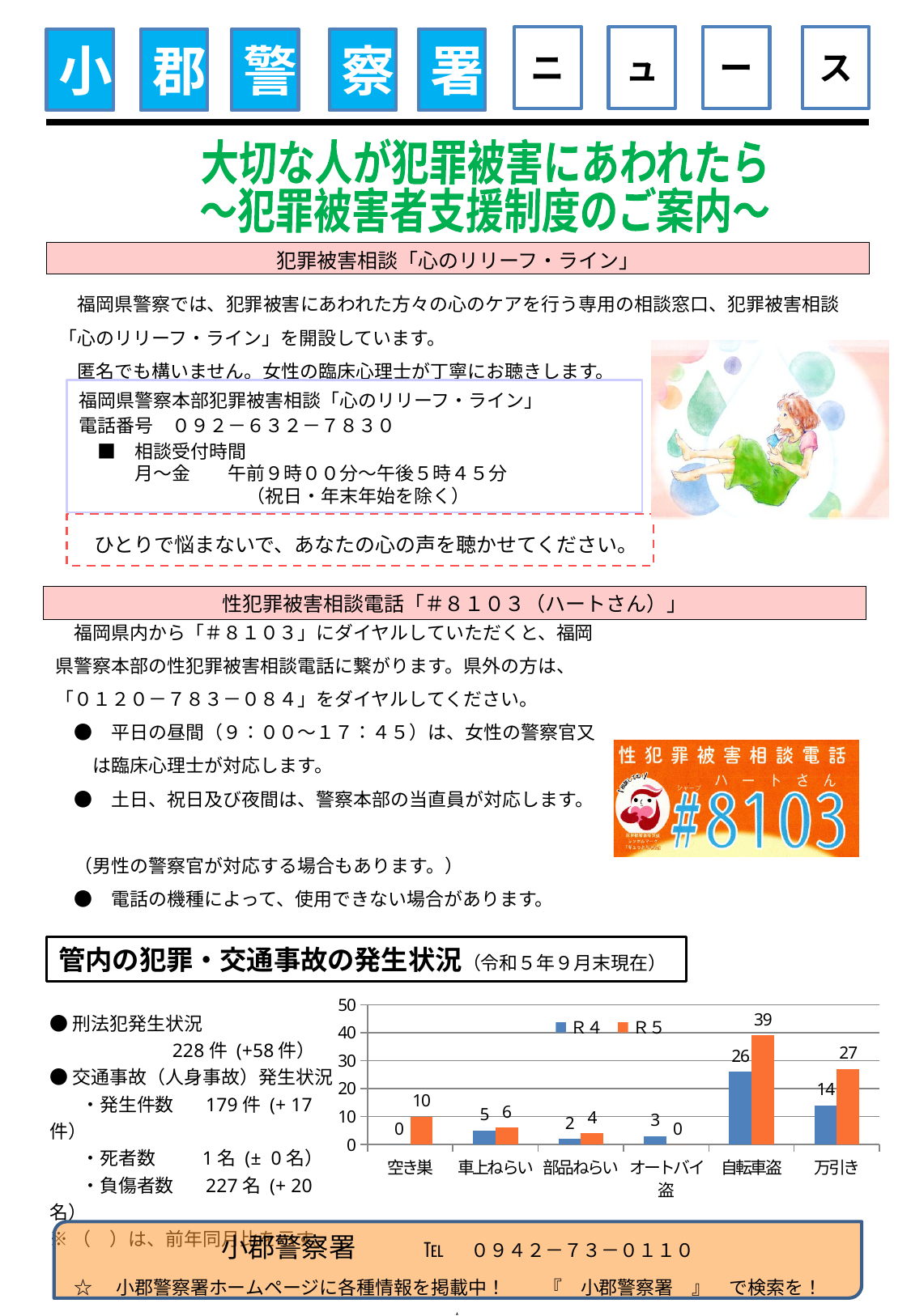
How many categories are shown on the x axis of the chart? 6 What is the R5 value for 空き巣? 10 What kind of chart is shown on the slide? bar chart What colour are the R5 bars in the chart? orange What is the R4 value for 万引き? 14 What is the R4 value for オートバイ盗? 3 Which category has the highest R5 value? 自転車盗 Which category has the lowest R4 value? 空き巣 How many series does the chart legend list? 2 What is the R5 value for 自転車盗? 39 Which is larger for 万引き, the R4 value or the R5 value? R5 What is the difference between the R5 and R4 values for 自転車盗? 13